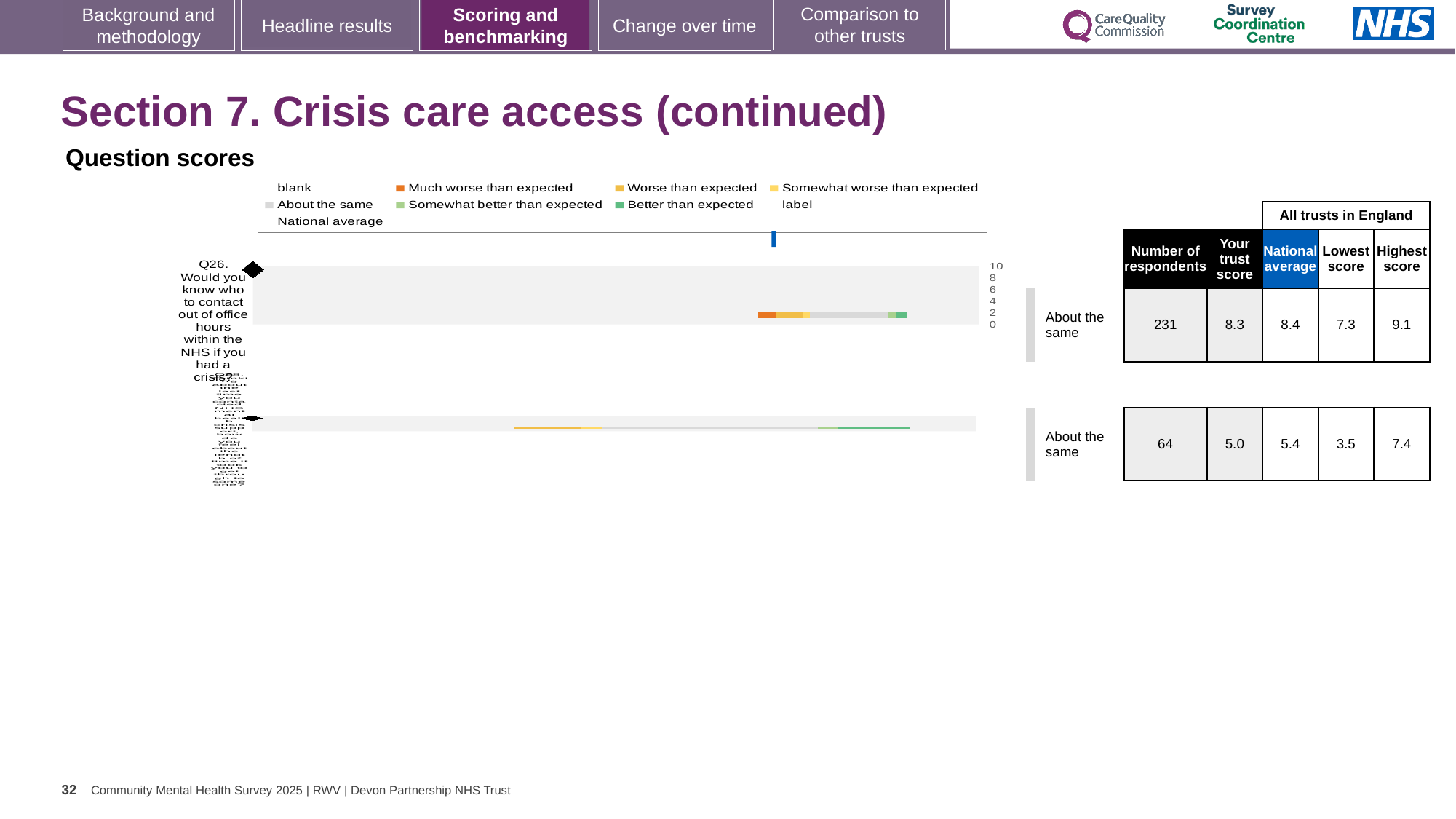
What is the benchmark category shown for Q26 next to the chart? About the same For Q26, what is the difference between the national average and your trust score? 0.1 In the table beside the chart, what is the lowest score among all trusts in England for Q26? 7.3 In the table beside the chart, what is the highest score among all trusts in England for Q26? 9.1 What colour does the legend use for 'Much worse than expected'? orange In the table beside the chart, what is the number of respondents for Q26? 231 For Q26, which is larger: your trust score or the national average? national average For Q26, what is the difference between the highest score and the lowest score among all trusts in England? 1.8 In the table beside the chart, what is 'Your trust score' for Q26? 8.3 What kind of chart is shown under 'Question scores'? bar chart In the table beside the chart, what is the national average for Q26? 8.4 Which question is labelled on the first row of the chart? Q26. Would you know who to contact out of office hours within the NHS if you had a crisis?